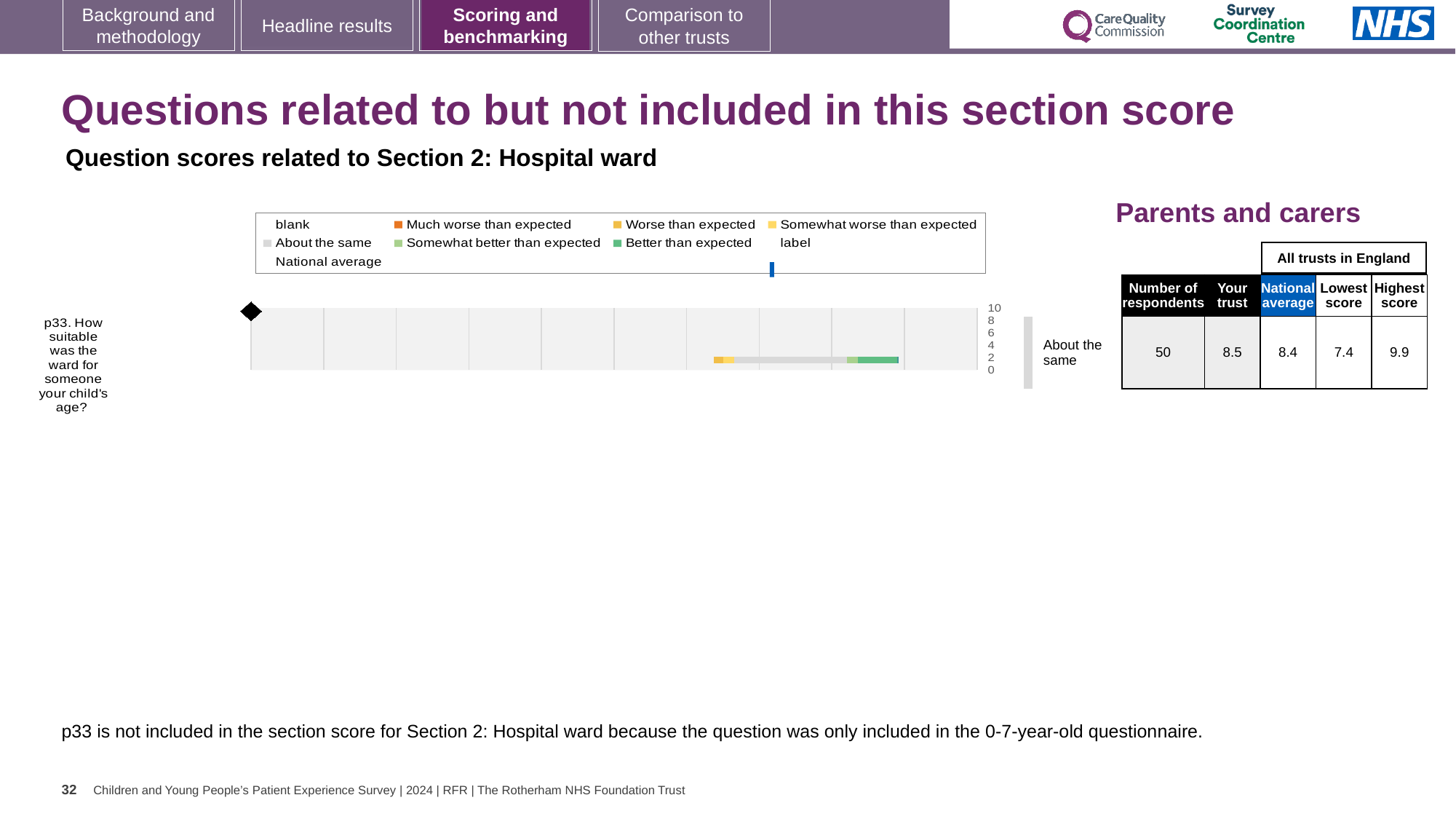
Which question is plotted in the chart? p33. How suitable was the ward for someone your child's age? In the table beside the chart, what is the Highest score for p33? 9.9 In the table beside the chart, which is larger for p33: the Your trust score or the National average? Your trust In the table beside the chart, what is the Your trust score for p33? 8.5 What benchmark category is shown next to the chart for p33? About the same What kind of chart is shown for question p33? bar chart In the table beside the chart, what is the Lowest score for p33? 7.4 In the table beside the chart, how many respondents answered p33? 50 In the table beside the chart, what is the difference between the Highest score and the Lowest score for p33? 2.5 What is the highest value shown on the chart's axis? 10 How many questions (categories) are plotted in the chart? 1 In the table beside the chart, what is the National average score for p33? 8.4